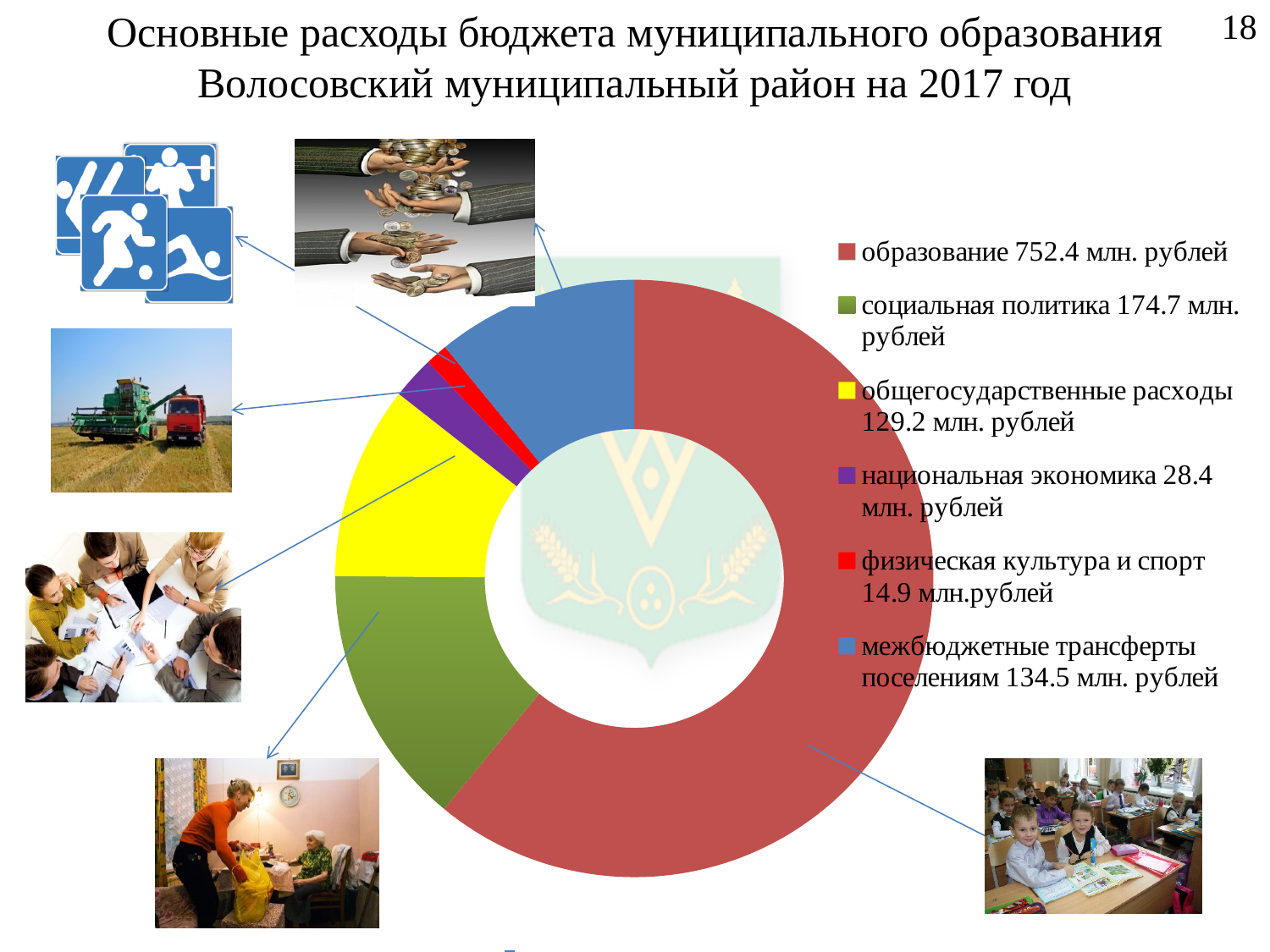
What is the value for физическая культура и спорт? 14.9 млн.рублей What is the value for общегосударственные расходы? 129.2 млн. рублей What is the value for социальная политика? 174.7 млн. рублей What is the value for межбюджетные трансферты поселениям? 134.5 млн. рублей How many categories does the chart show? 6 What is the value for образование? 752.4 млн. рублей Which category has the largest share of the chart? образование Which is larger, межбюджетные трансферты поселениям or общегосударственные расходы? межбюджетные трансферты поселениям What is the difference between образование and социальная политика? 577.7 млн. рублей What kind of chart is shown on the slide? doughnut chart Which category has the smallest share of the chart? физическая культура и спорт What is the value for национальная экономика? 28.4 млн. рублей